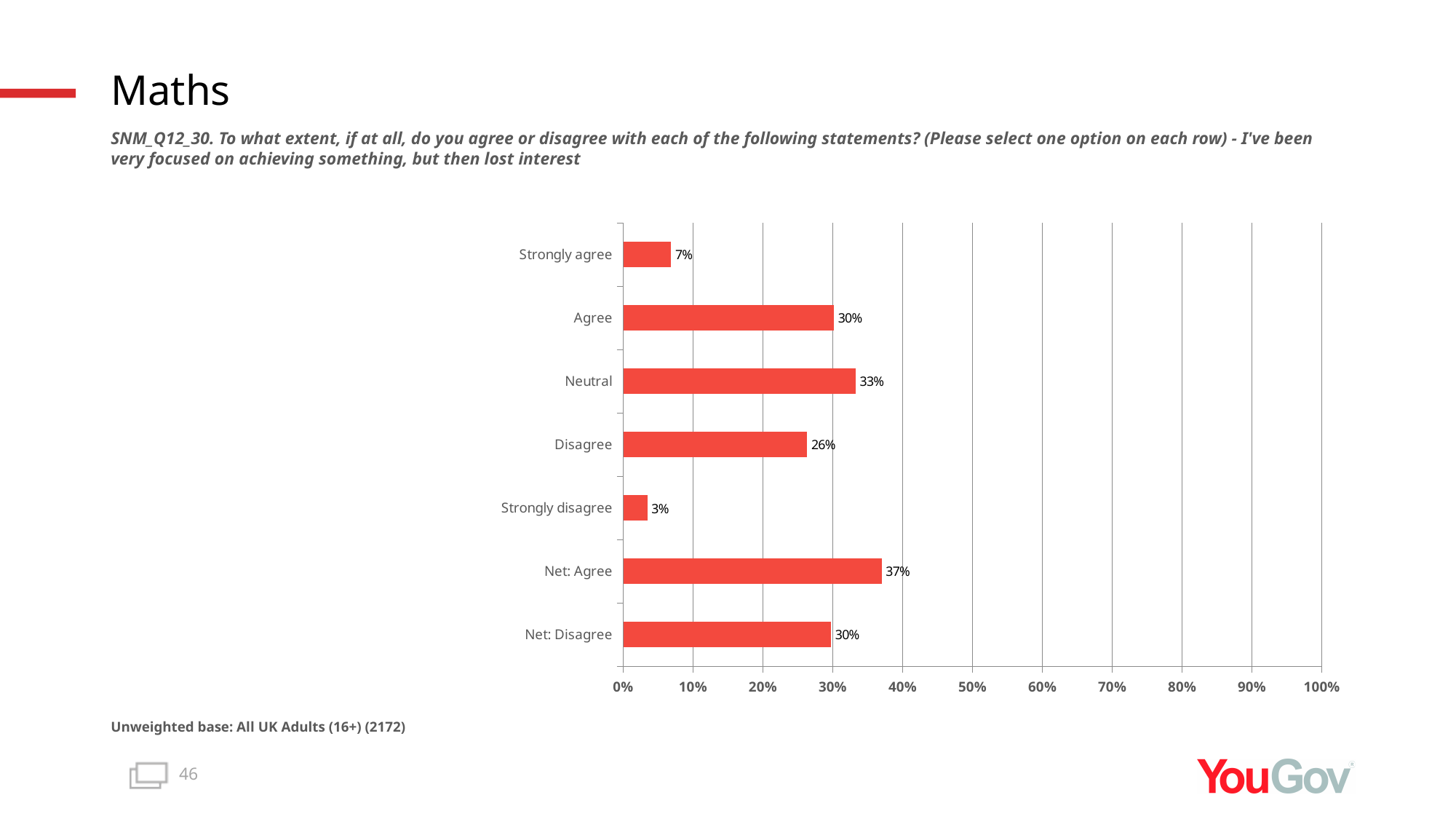
Is the value for 'Neutral' greater or less than 30%? greater Which is larger, 'Agree' or 'Disagree'? Agree What is the unweighted base stated below the chart? All UK Adults (16+) (2172) What is the difference between 'Net: Agree' and 'Net: Disagree'? 7% What percentage is shown for 'Net: Agree'? 37% What is the difference between 'Agree' and 'Strongly agree'? 23% What percentage of respondents selected 'Strongly agree'? 7% How many categories are shown on the chart? 7 Which category has the lowest value? Strongly disagree What kind of chart is shown on the slide? Bar chart What is the value shown for 'Neutral'? 33% Which category has the highest value? Net: Agree